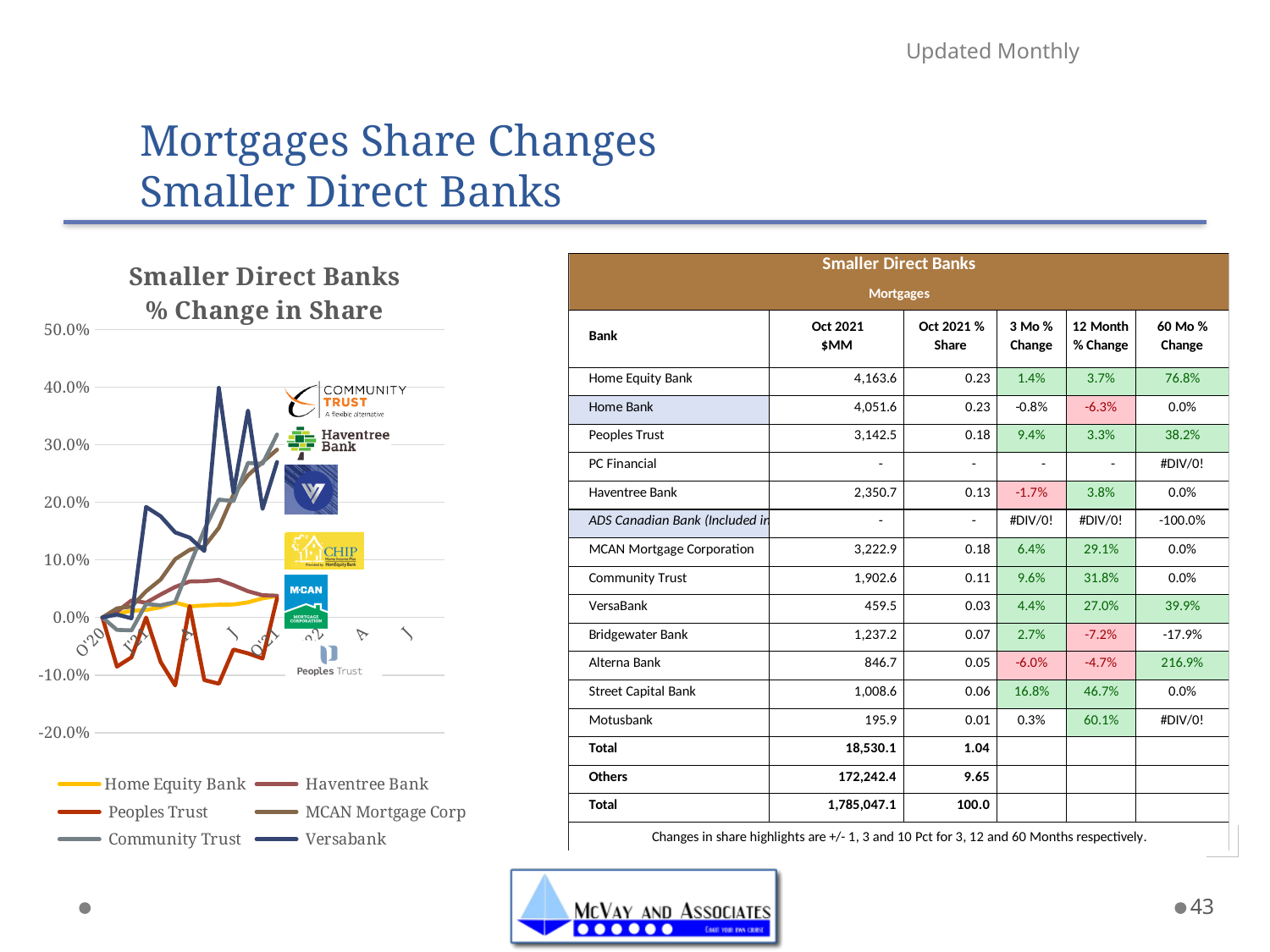
Is the peak value for Versabank greater or less than 30.0%? greater Which series reaches the highest value on the chart? Versabank What is the title of the chart? Smaller Direct Banks % Change in Share At the end of the series, is the value for Versabank larger or smaller than the value for Peoples Trust? larger Does the MCAN Mortgage Corp series rise or fall overall along the x axis? rise Is the highest value for Haventree Bank greater or less than 10.0%? less What is the highest value shown on the vertical axis of the chart? 50.0% Is the highest value for Home Equity Bank greater or less than 10.0%? less Which series reaches the lowest value on the chart? Peoples Trust How many series does the legend of the chart list? 6 What kind of chart is shown on the slide? Line chart